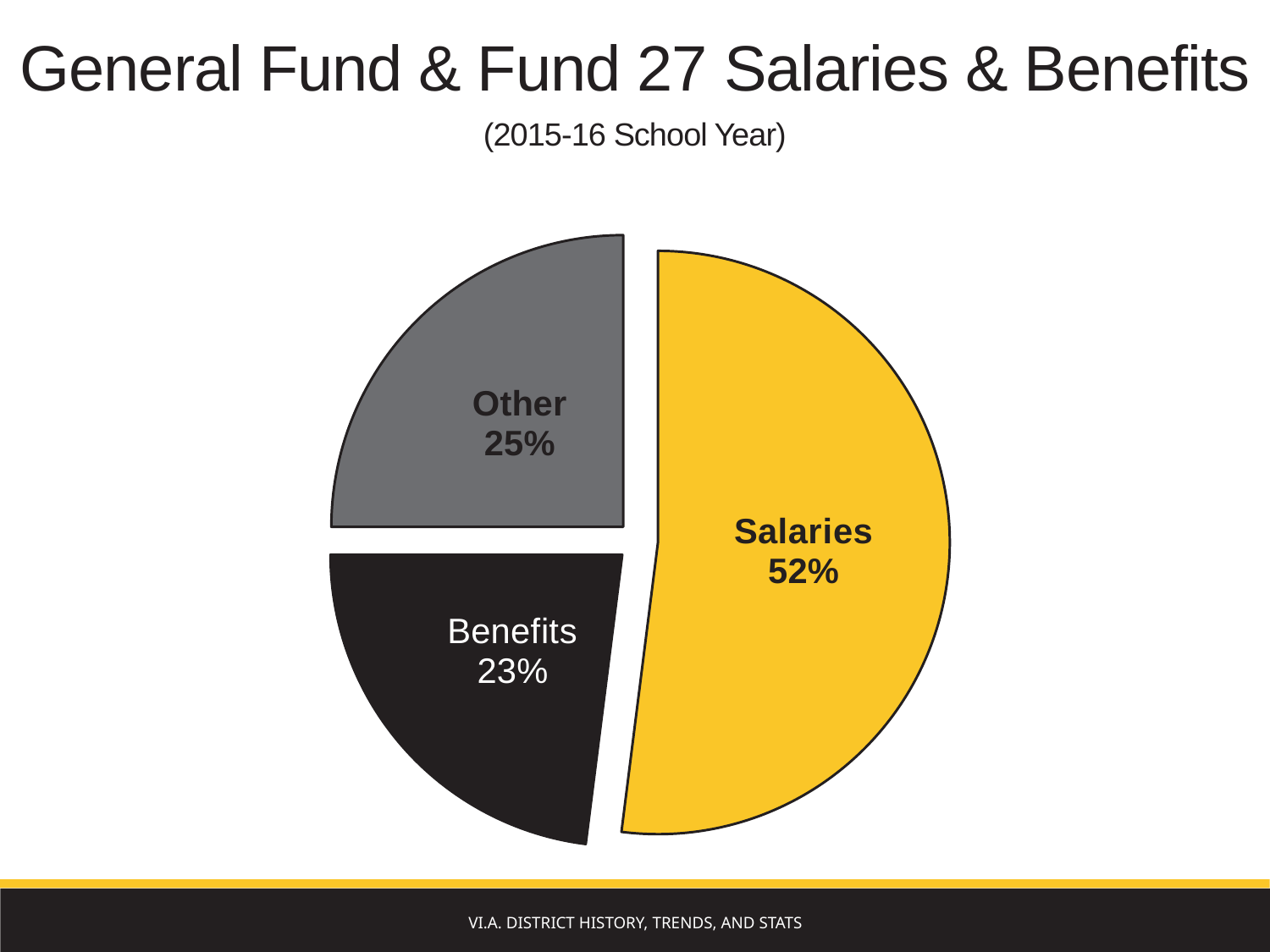
What is the difference in percentage points between Other and Benefits? 2 Which is larger, the Salaries slice or the Other slice? Salaries What share of the pie does Other represent? 25% What kind of chart is shown on the slide? Pie chart What share of the pie does Benefits represent? 23% Which slice of the pie is the smallest? Benefits What colour is the Salaries slice? Yellow Which slice of the pie is the largest? Salaries What share of the pie does Salaries represent? 52% How many slices does the pie chart have? 3 What is the combined share of Salaries and Benefits? 75% What is the difference in percentage points between Salaries and Benefits? 29